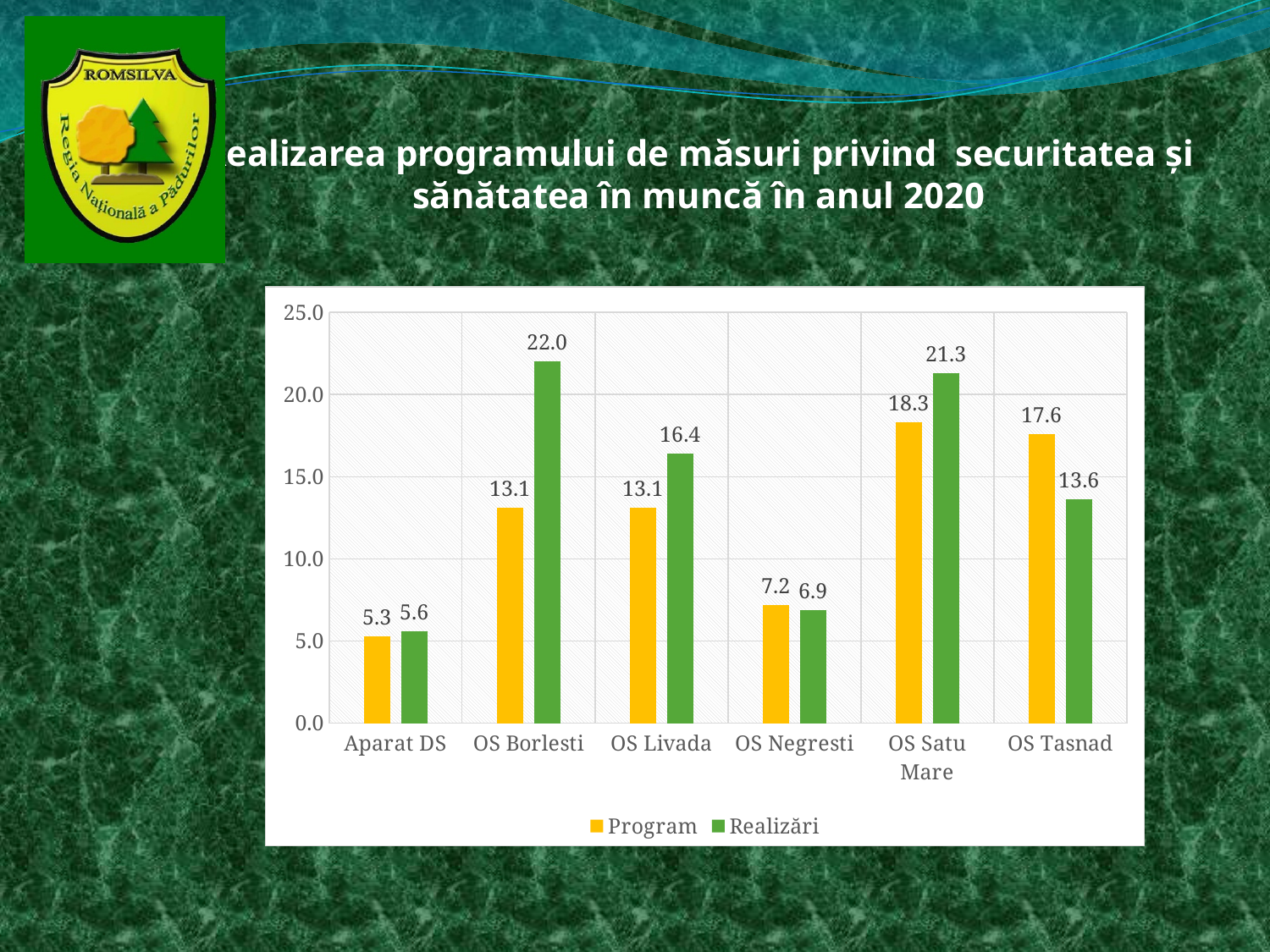
What is the Realizări value for OS Satu Mare? 21.3 Which category has the lowest Program value? Aparat DS How many categories are shown on the x axis? 6 How many series does the legend list? 2 What is the Realizări value for OS Negresti? 6.9 What is the difference between the Program and Realizări values for OS Tasnad? 4.0 Is the Realizări value for OS Livada greater or less than 15.0? greater For OS Negresti, which is larger, the Program value or the Realizări value? Program What kind of chart is shown on the slide? bar chart Which category has the highest Realizări value? OS Borlesti What is the Program value for OS Borlesti? 13.1 What is the difference between the Realizări and Program values for OS Borlesti? 8.9